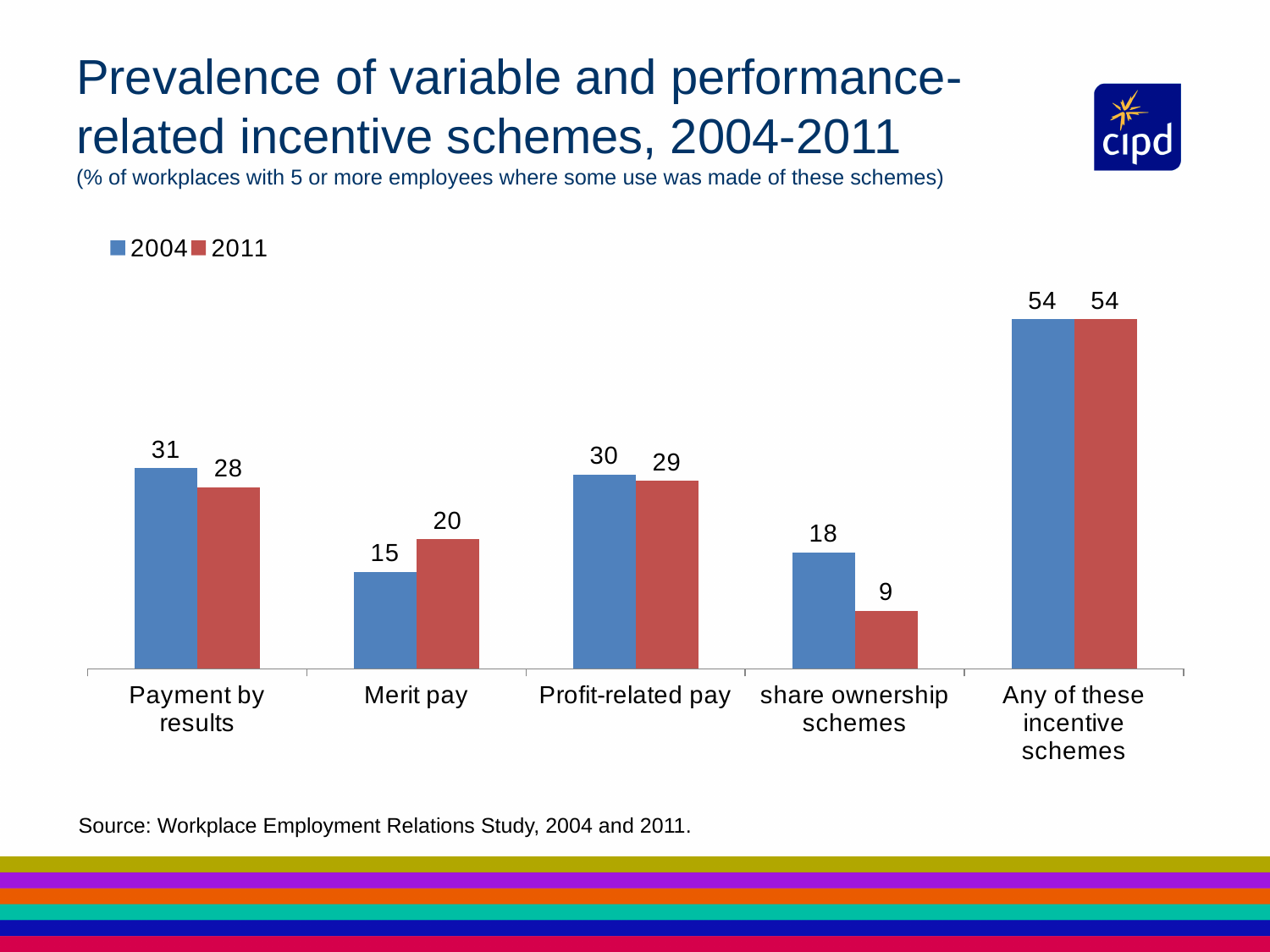
What is the difference between the 2004 and 2011 values for Profit-related pay? 1 Which is larger for Merit pay, the 2004 value or the 2011 value? 2011 What is the 2011 value for share ownership schemes? 9 What is the 2004 value for Payment by results? 31 What is the difference between the 2004 and 2011 values for share ownership schemes? 9 Which category has the highest 2011 value? Any of these incentive schemes How many categories are shown on the x axis? 5 How many series does the legend list? 2 Which category has the lowest 2004 value? Merit pay What kind of chart is shown on the slide? Bar chart What is the 2011 value for Merit pay? 20 Which series does the red colour represent in the legend? 2011